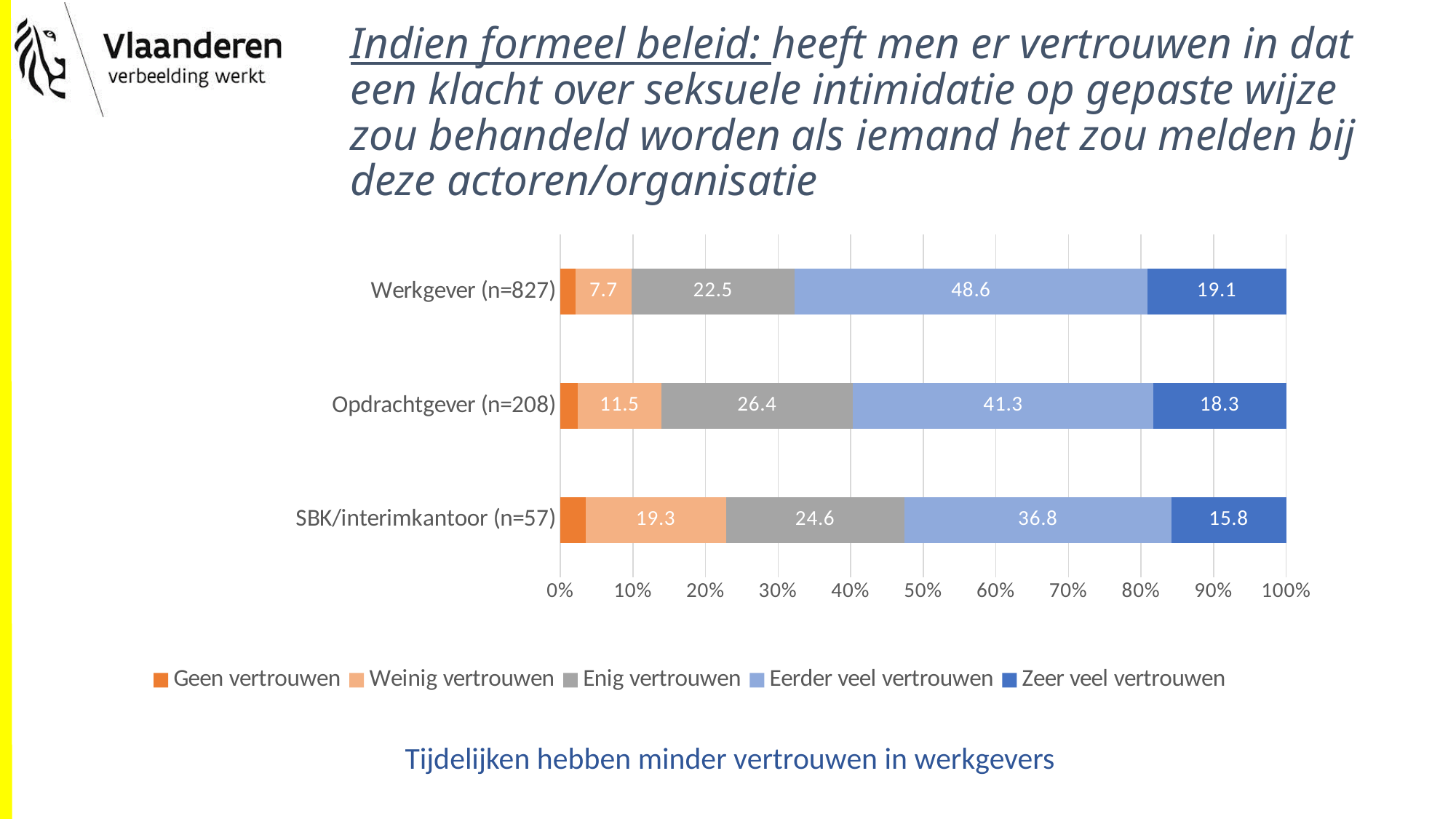
Which is larger: the Enig vertrouwen value for Opdrachtgever (n=208) or for SBK/interimkantoor (n=57)? Opdrachtgever (n=208) What is the value for Enig vertrouwen for Opdrachtgever (n=208)? 26.4 What is the difference between the Eerder veel vertrouwen values for Werkgever (n=827) and SBK/interimkantoor (n=57)? 11.8 Which category has the highest value for Eerder veel vertrouwen? Werkgever (n=827) What is the value for Zeer veel vertrouwen for SBK/interimkantoor (n=57)? 15.8 How many series does the legend list? 5 Which category has the lowest value for Zeer veel vertrouwen? SBK/interimkantoor (n=57) How many categories are shown on the chart? 3 What is the value for Weinig vertrouwen for SBK/interimkantoor (n=57)? 19.3 What kind of chart is shown on the slide? Stacked bar chart What is the value for Eerder veel vertrouwen for Werkgever (n=827)? 48.6 Is the Geen vertrouwen value for SBK/interimkantoor (n=57) greater or less than 10%? less